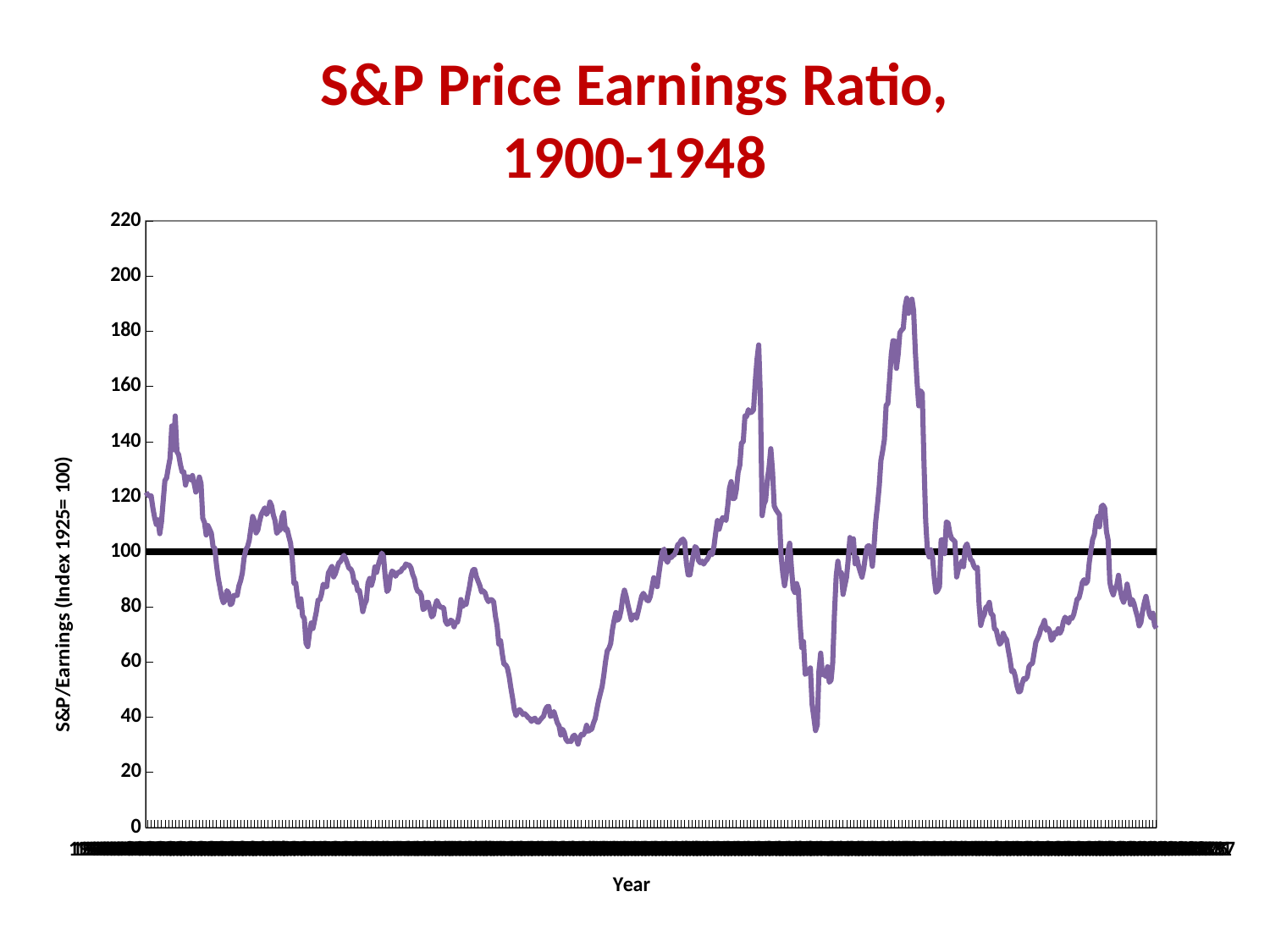
What is the label on the vertical axis of the chart? S&P/Earnings (Index 1925= 100) What is the highest tick value shown on the vertical axis? 220 Is the lowest value reached by the purple line greater or less than 40? less Is the highest value reached by the purple line greater or less than 180? greater Is the highest value reached by the purple line greater or less than 200? less What kind of chart is shown on the slide? line chart What is the title of the chart? S&P Price Earnings Ratio, 1900-1948 At what value on the vertical axis is the thick black horizontal reference line drawn? 100